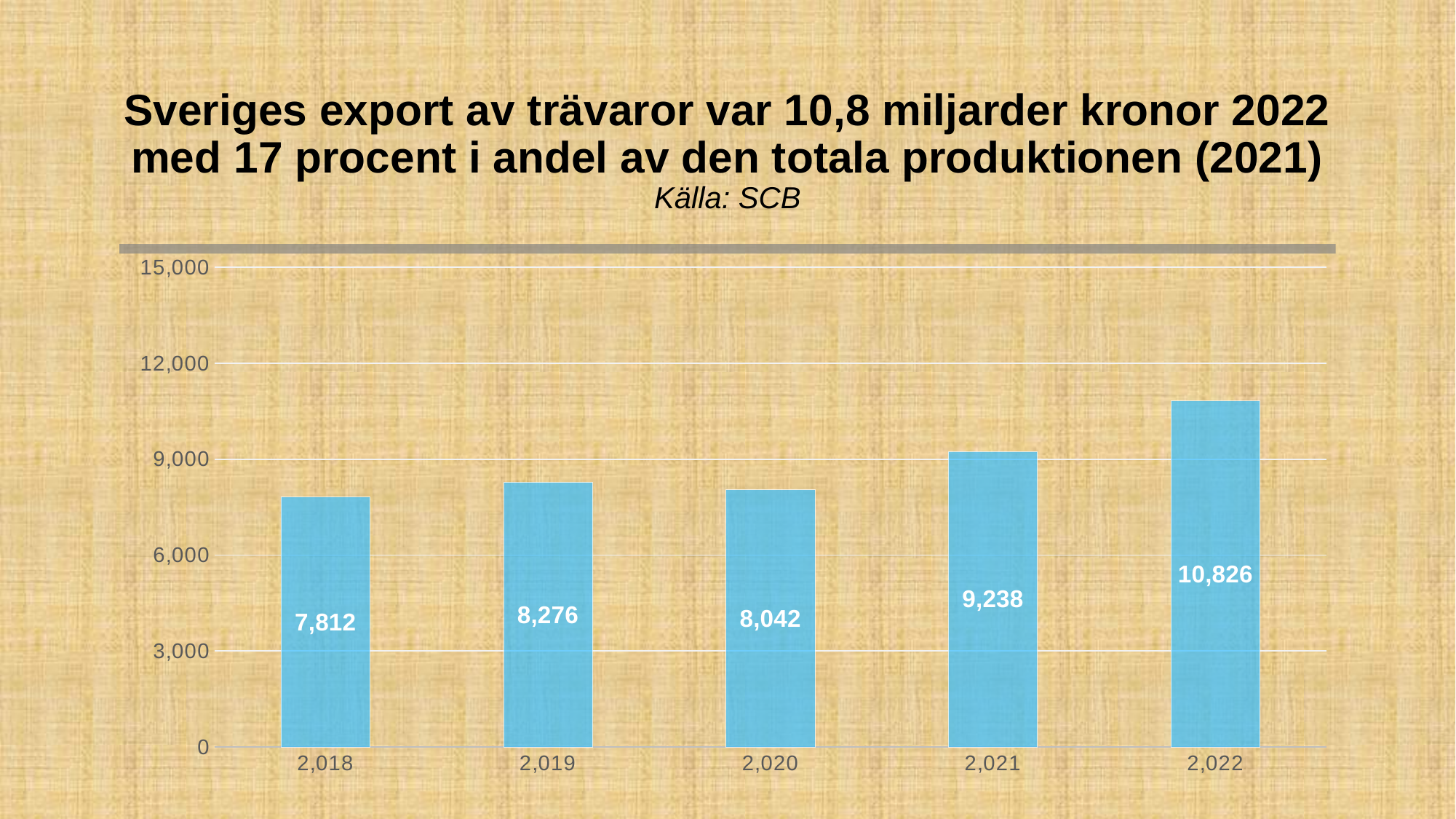
How many bars are shown in the chart? 5 What kind of chart is shown on the slide? bar chart What source is cited below the slide title? SCB Which year has the highest value? 2,022 What is the value shown for 2,022? 10,826 What is the difference between the values for 2,019 and 2,020? 234 Which is larger, the value for 2,019 or the value for 2,020? 2,019 What is the difference between the values for 2,022 and 2,021? 1,588 Is the value for 2,021 greater or less than 9,000? greater What is the value shown for 2,021? 9,238 Which year has the lowest value? 2,018 What is the value shown for 2,018? 7,812